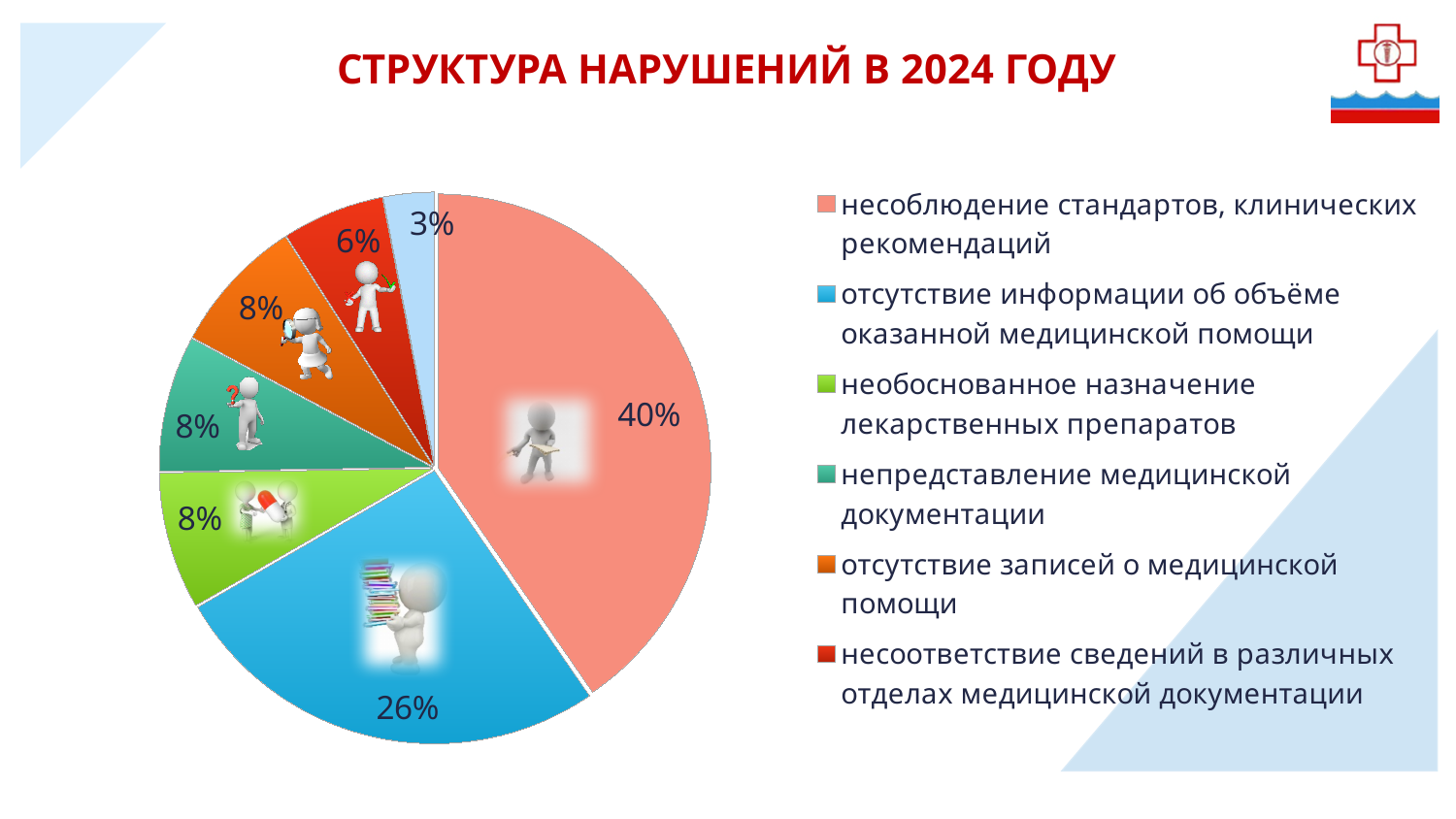
What share of the pie is labelled for "несоответствие сведений в различных отделах медицинской документации"? 6% What share of the pie is labelled for "необоснованное назначение лекарственных препаратов"? 8% How many slices does the pie chart have? 7 What share of the pie is labelled for "отсутствие информации об объёме оказанной медицинской помощи"? 26% How many entries does the legend list? 6 What is the title of the chart on the slide? СТРУКТУРА НАРУШЕНИЙ В 2024 ГОДУ Which category has the largest slice of the pie? несоблюдение стандартов, клинических рекомендаций Which is larger: the slice for "отсутствие записей о медицинской помощи" or the slice for "несоответствие сведений в различных отделах медицинской документации"? отсутствие записей о медицинской помощи What share of the pie is labelled for "несоблюдение стандартов, клинических рекомендаций"? 40% What is the difference in percentage points between the 40% slice and the 26% slice? 14 What is the smallest percentage labelled on the pie chart? 3% What kind of chart is shown on the slide? pie chart